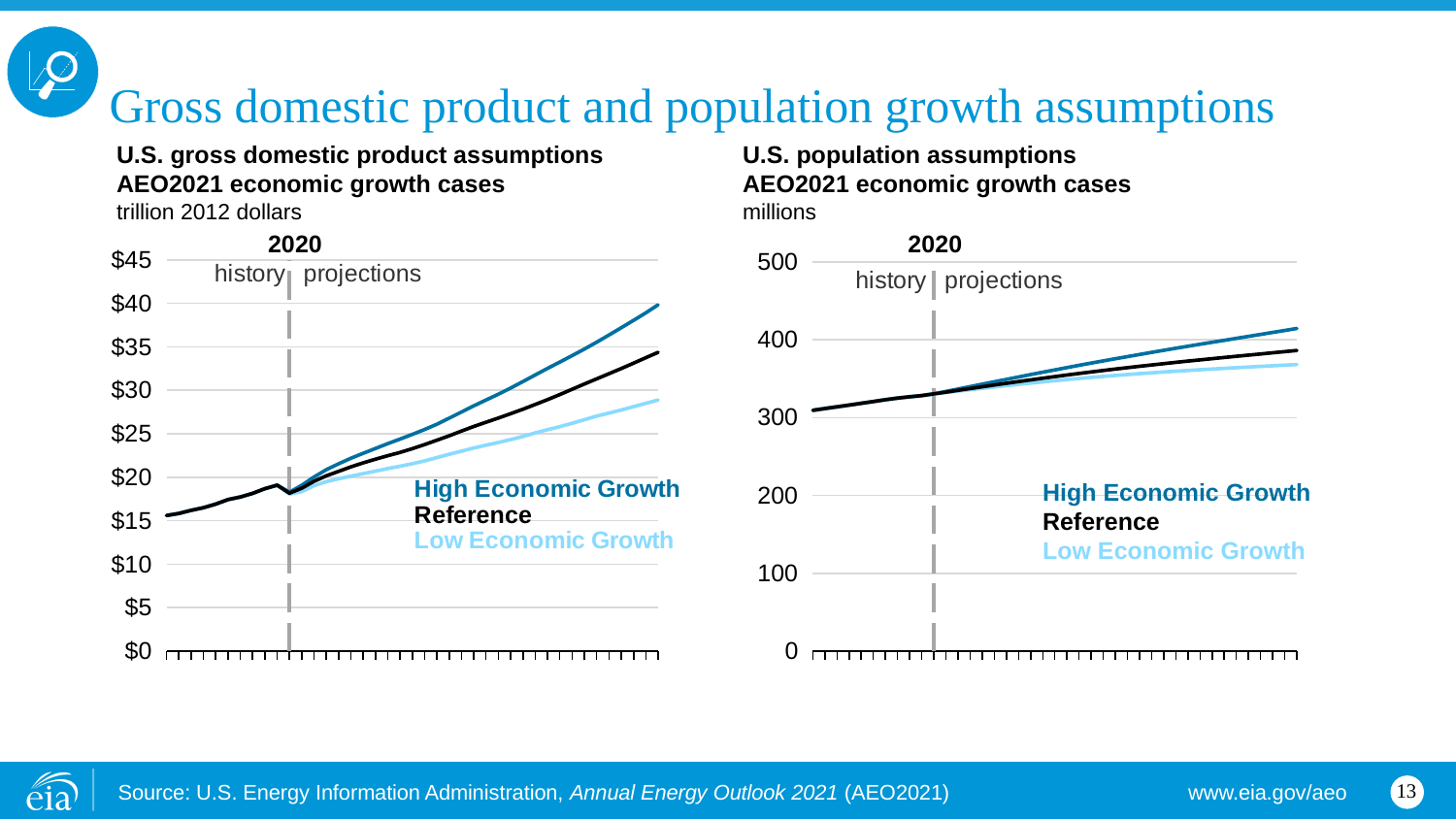
In the U.S. gross domestic product assumptions chart, is the final value of the Low Economic Growth line greater or less than $35? less In the U.S. gross domestic product assumptions chart, is the final value of the High Economic Growth line greater or less than $35? greater In the U.S. population assumptions chart, what unit are the values expressed in? millions In the U.S. gross domestic product assumptions chart, which line ends higher at the end of the projections, Reference or Low Economic Growth? Reference How many series are shown in the U.S. population assumptions chart? 3 In the U.S. gross domestic product assumptions chart, does the High Economic Growth line rise or fall over the projection period? rise In the U.S. population assumptions chart, is the final value of the Low Economic Growth line greater or less than 400? less In the U.S. gross domestic product assumptions chart, what unit are the values expressed in? trillion 2012 dollars What type of chart is the U.S. gross domestic product assumptions chart? line chart In the U.S. population assumptions chart, which line ends higher at the end of the projections, High Economic Growth or Low Economic Growth? High Economic Growth